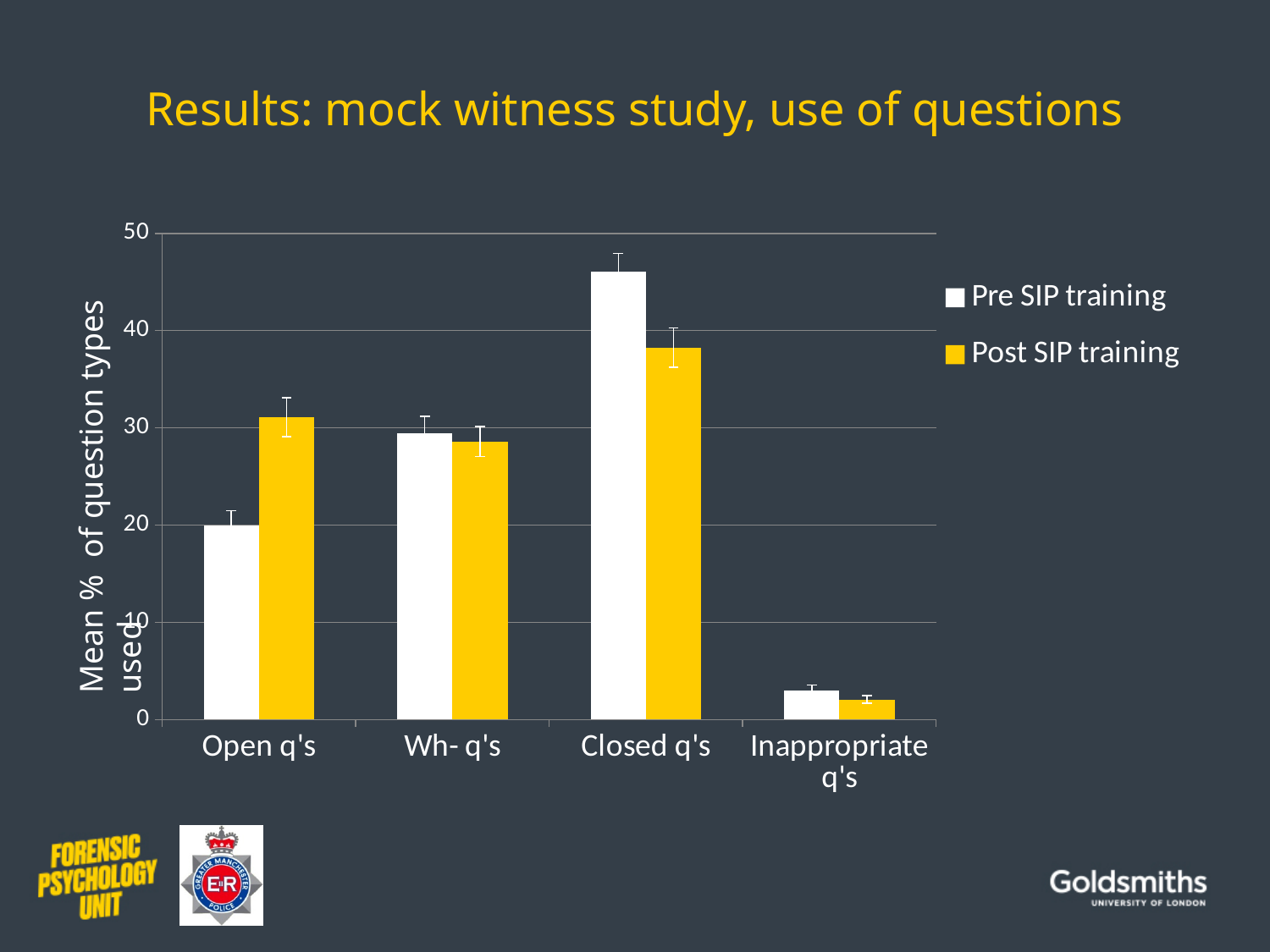
Is the Pre SIP training value for Closed q's greater or less than 40? greater For Open q's, which is larger: Pre SIP training or Post SIP training? Post SIP training What is the title of the slide? Results: mock witness study, use of questions For Closed q's, which is larger: Pre SIP training or Post SIP training? Pre SIP training Which category has the highest Post SIP training value? Closed q's How many series does the legend list? 2 Which category has the highest Pre SIP training value? Closed q's What kind of chart is shown on the slide? bar chart How many question-type categories are shown on the x axis? 4 Is the Post SIP training value for Closed q's greater or less than 40? less Which category has the lowest Post SIP training value? Inappropriate q's Is the Pre SIP training value for Inappropriate q's greater or less than 10? less